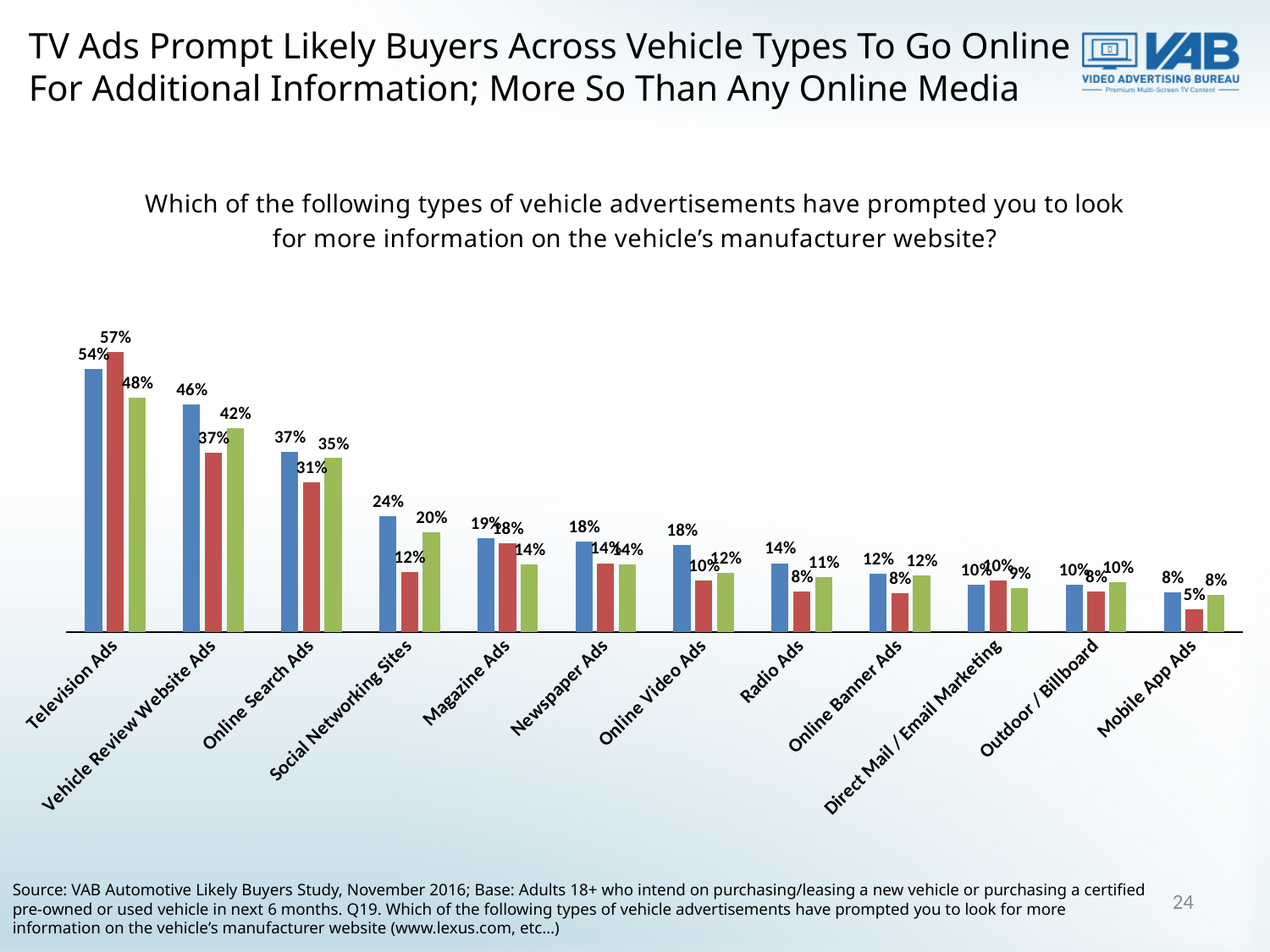
How many advertisement categories are shown on the x axis? 12 Which is larger for Online Search Ads, the blue bar or the red bar? the blue bar Which category has the lowest value for the red bars? Mobile App Ads What is the difference between the red bar and the blue bar for Television Ads? 3% Do the blue bar values generally rise or fall moving from left to right along the x axis? fall What is the value of the blue bar for Television Ads? 54% What kind of chart is shown on the slide? bar chart What is the value of the green bar for Vehicle Review Website Ads? 42% What is the value of the red bar for Mobile App Ads? 5% What is the value of the red bar for Social Networking Sites? 12% What is the difference between the blue bar and the green bar for Social Networking Sites? 4% Which category has the highest value for the blue bars? Television Ads